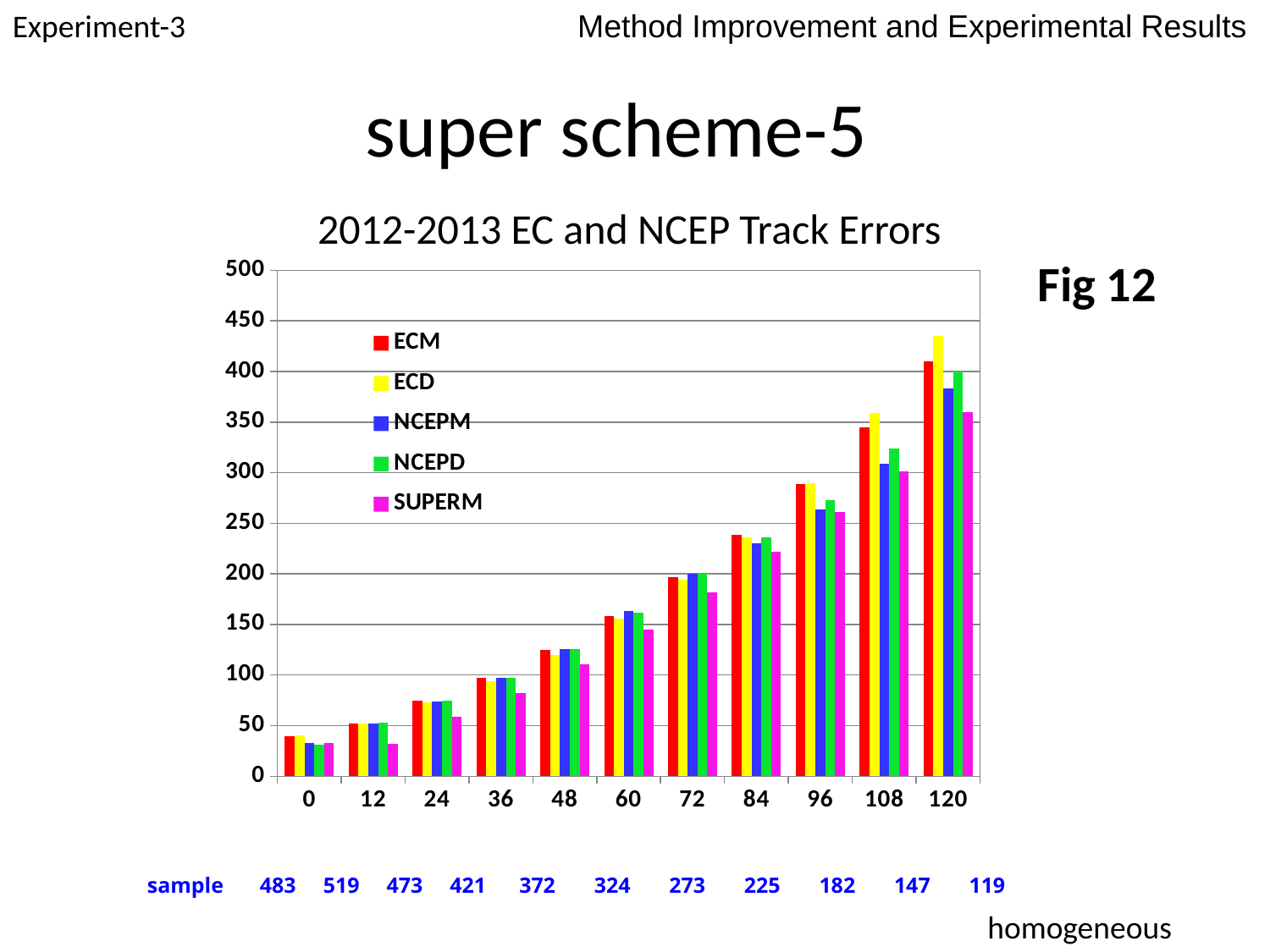
Is the value for SUPERM at 120 greater or less than 400? less How many categories are shown along the x axis? 11 What kind of chart is shown on the slide? bar chart At 96, which is larger, the value for ECM or the value for NCEPM? ECM Which series has the highest value at 120? ECD Is the value for ECM at 108 greater or less than 300? greater How many series does the legend list? 5 Is the value for ECD at 120 greater or less than 400? greater What is the title of the chart? 2012-2013 EC and NCEP Track Errors Which series is shown in yellow in the legend? ECD Do the track error values rise or fall as the x-axis value increases from 0 to 120? rise Which series has the lowest value at 120? SUPERM